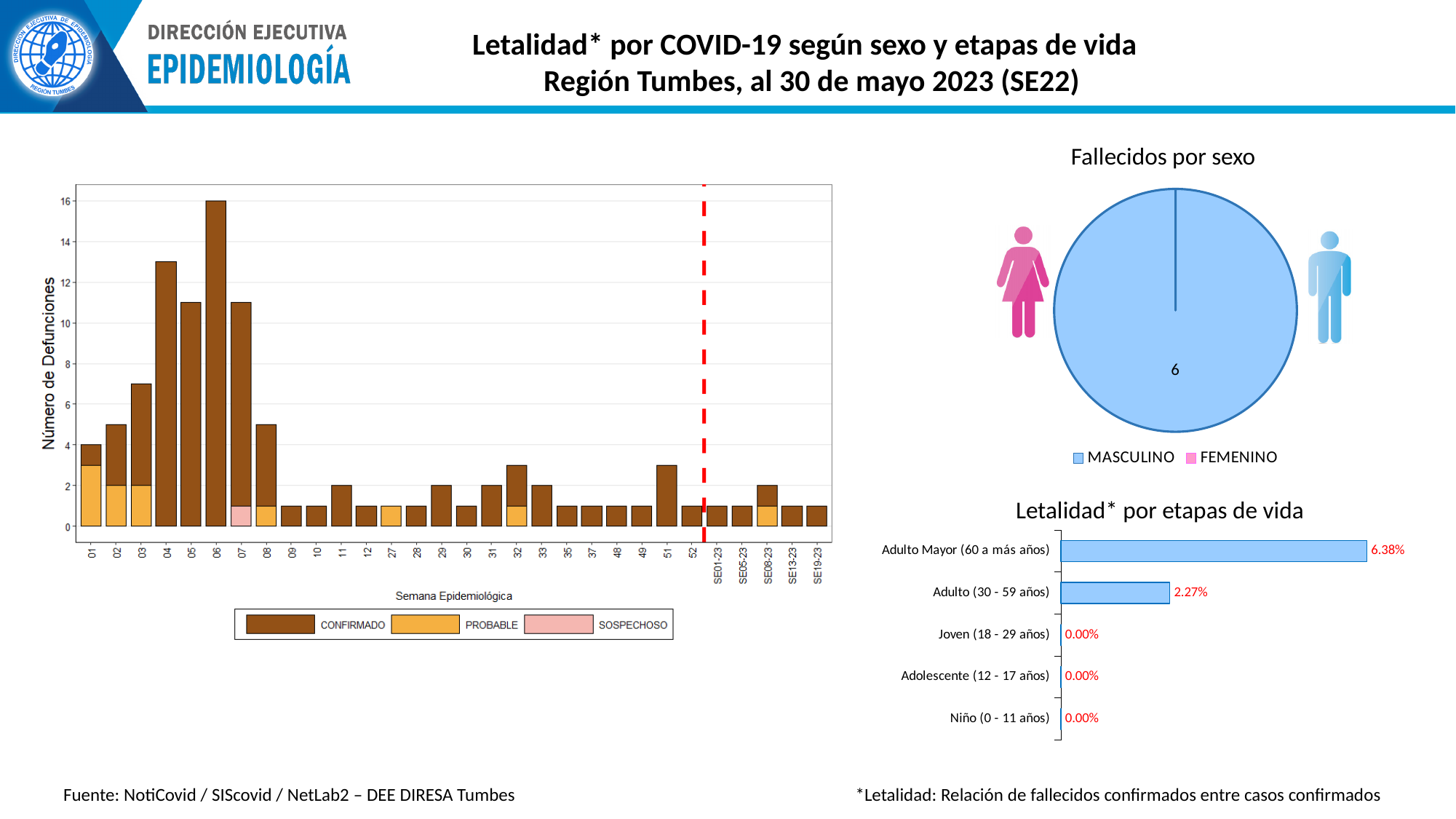
In the 'Fallecidos por sexo' chart, what is the value shown for MASCULINO? 6 In the 'Letalidad* por etapas de vida' chart, what is the difference between the values for Adulto Mayor (60 a más años) and Adulto (30 - 59 años)? 4.11% In the 'Letalidad* por etapas de vida' chart, how many age groups are shown? 5 In the 'Letalidad* por etapas de vida' chart, which age group has the highest value? Adulto Mayor (60 a más años) In the chart on the left showing Número de Defunciones by Semana Epidemiológica, how many series does the legend list? 3 In the 'Letalidad* por etapas de vida' chart, what is the value for Adulto (30 - 59 años)? 2.27% In the chart on the left showing Número de Defunciones by Semana Epidemiológica, which week has the highest number of deaths? 06 In the 'Letalidad* por etapas de vida' chart, what is the value for Joven (18 - 29 años)? 0.00% What kind of chart is 'Fallecidos por sexo'? pie chart In the chart on the left showing Número de Defunciones by Semana Epidemiológica, is the value for week 04 greater or less than 12? greater In the 'Letalidad* por etapas de vida' chart, what is the value for Adulto Mayor (60 a más años)? 6.38% In the 'Fallecidos por sexo' chart, how many entries does the legend list? 2